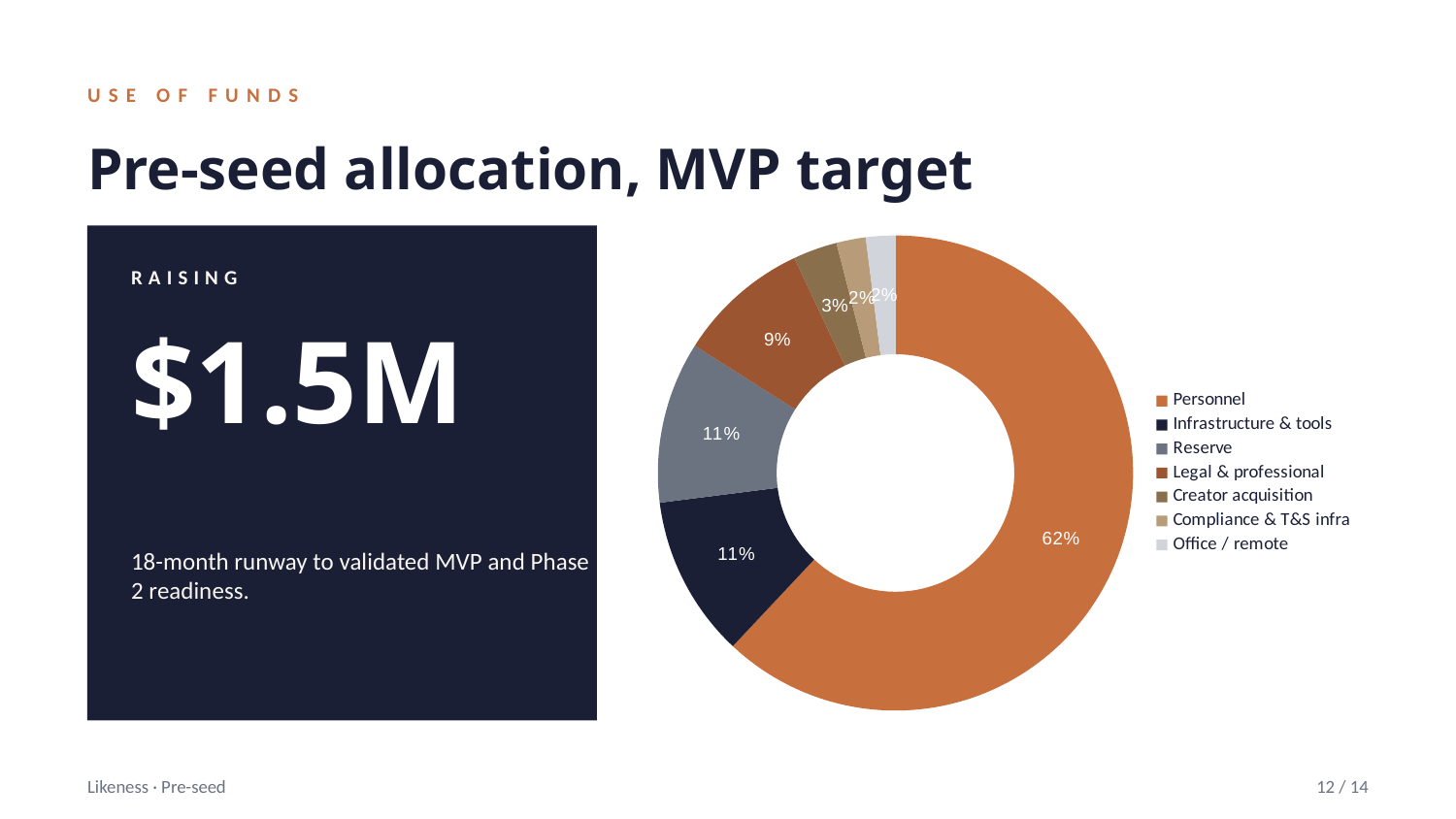
What kind of chart is shown on the slide? Doughnut chart What is the difference in percentage points between Reserve and Legal & professional? 2 Which is larger, the share for Legal & professional or the share for Creator acquisition? Legal & professional What is the difference in percentage points between Personnel and Infrastructure & tools? 51 How many categories does the legend list? 7 Which category is listed last in the legend? Office / remote Which category has the largest share of the allocation? Personnel What share of the allocation goes to Reserve? 11% What is the combined share of Infrastructure & tools and Reserve? 22% What share of the allocation goes to Creator acquisition? 3% What share of the pre-seed allocation goes to Personnel? 62% What share of the allocation goes to Legal & professional? 9%